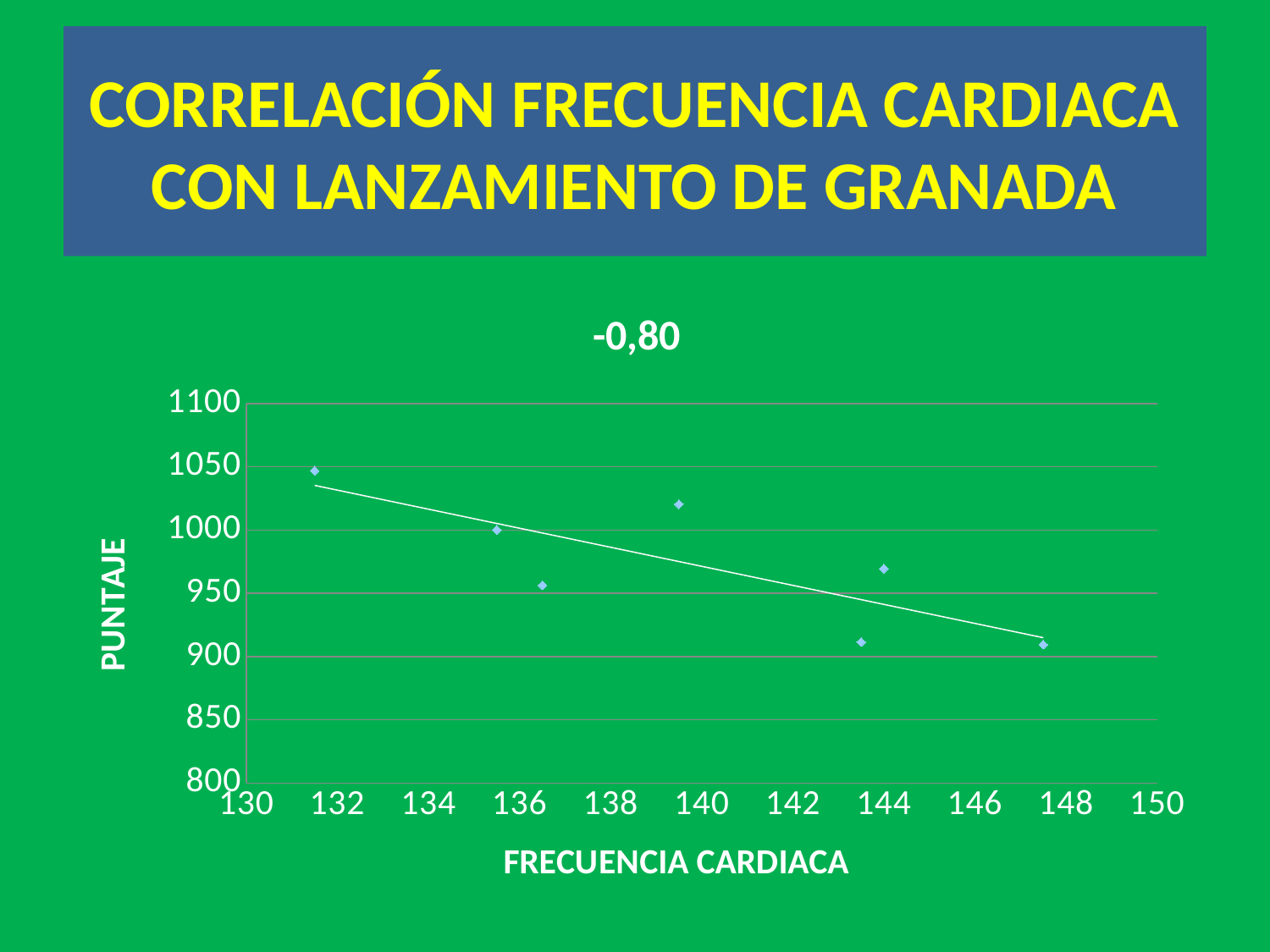
Is the PUNTAJE value for the point near FRECUENCIA CARDIACA 136 greater or less than 1050? less How many data points are plotted in the chart? 7 Do the PUNTAJE values generally rise or fall as FRECUENCIA CARDIACA increases along the x axis? fall What is the label of the vertical axis? PUNTAJE Is the PUNTAJE value for the point near FRECUENCIA CARDIACA 140 greater or less than 1000? greater Which has the higher PUNTAJE: the point near FRECUENCIA CARDIACA 132 or the point near FRECUENCIA CARDIACA 148? the point near 132 What kind of chart is shown on the slide? scatter chart What is the title shown above the chart? -0,80 Is the PUNTAJE value for the point with the highest FRECUENCIA CARDIACA (near 148) greater or less than 950? less What is the highest value shown on the vertical axis? 1100